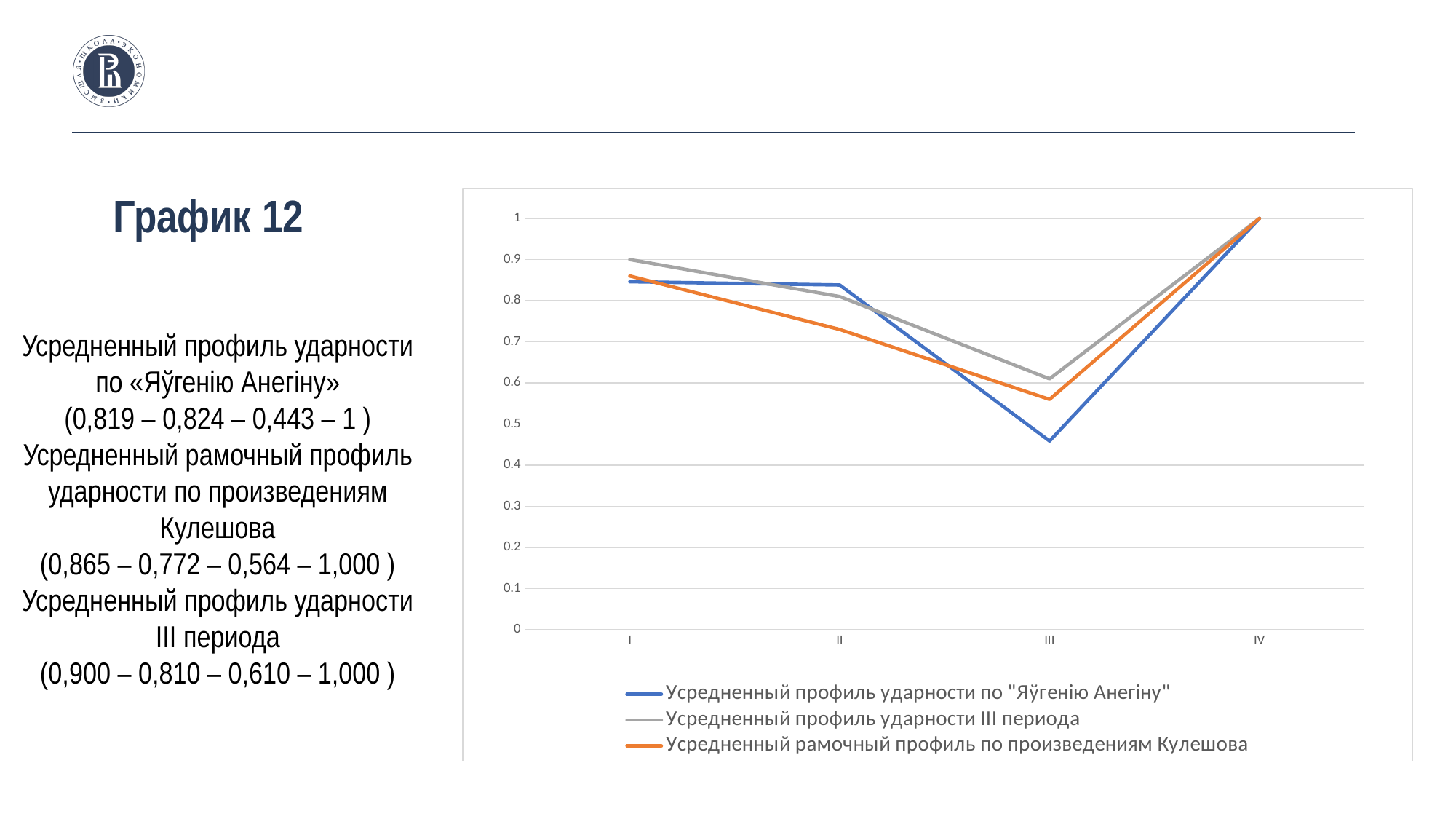
At which category does the series "Усредненный профиль ударности по "Яўгенію Анегіну"" reach its lowest value? III What kind of chart is shown on the slide? line chart How many categories are shown on the x axis of the chart? 4 Is the value of the series "Усредненный рамочный профиль по произведениям Кулешова" at II greater or less than 0.7? greater Does the series "Усредненный профиль ударности по "Яўгенію Анегіну"" rise or fall from II to III? fall At category III, which series has the larger value: "Усредненный профиль ударности III периода" or "Усредненный профиль ударности по "Яўгенію Анегіну""? Усредненный профиль ударности III периода What value do all three series reach at category IV? 1 What is the value of the series "Усредненный профиль ударности III периода" at category I? 0.9 What is the title of the chart given on the slide? График 12 Is the value of the series "Усредненный профиль ударности III периода" at III greater or less than 0.7? less Is the value of the series "Усредненный профиль ударности по "Яўгенію Анегіну"" at III greater or less than 0.5? less How many series does the chart legend list? 3